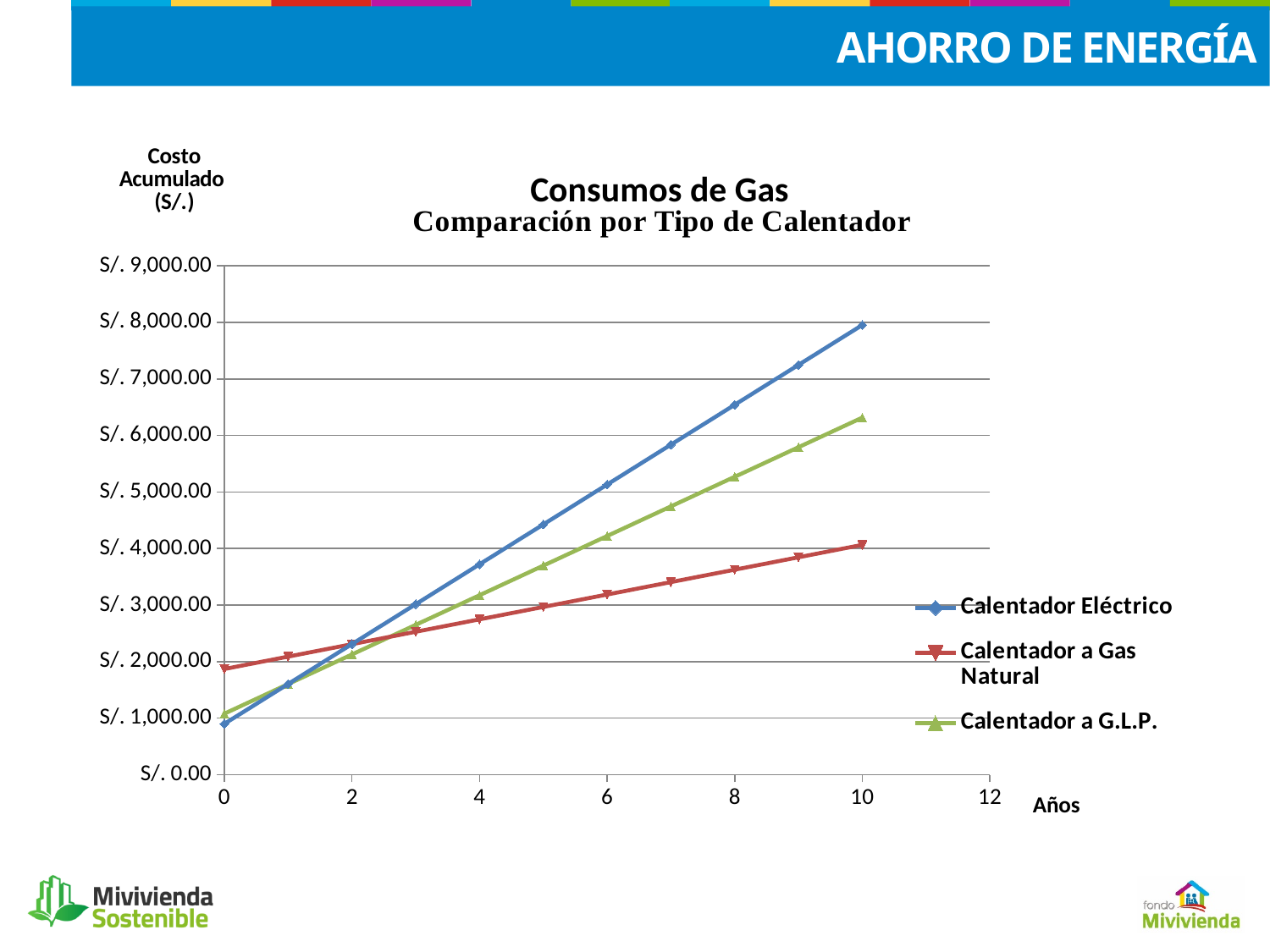
Is the value for Calentador a G.L.P. at year 10 greater or less than S/. 6,000.00? greater Which series has the highest cumulative cost at year 10? Calentador Eléctrico What is the subtitle shown under the chart title 'Consumos de Gas'? Comparación por Tipo de Calentador Do the values for Calentador Eléctrico rise or fall as the years increase? rise Is the value for Calentador Eléctrico at year 10 greater or less than S/. 7,000.00? greater At year 10, which is higher: Calentador a G.L.P. or Calentador a Gas Natural? Calentador a G.L.P. What kind of chart is shown on the slide? line chart At year 0, which is higher: Calentador Eléctrico or Calentador a Gas Natural? Calentador a Gas Natural How many series does the legend list? 3 Is the value for Calentador a Gas Natural at year 10 greater or less than S/. 5,000.00? less Which series has the lowest cumulative cost at year 10? Calentador a Gas Natural What is the label of the x axis? Años